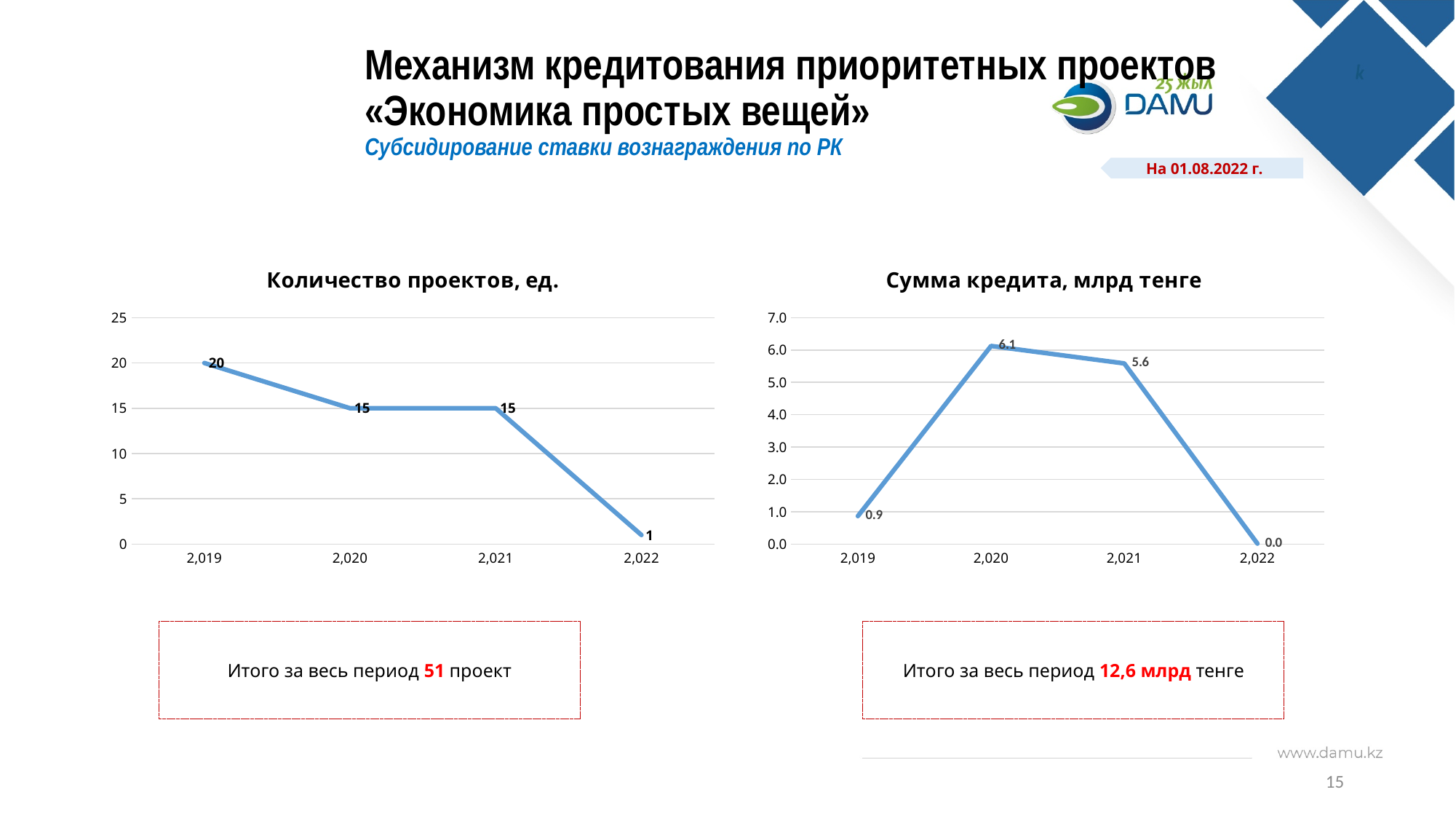
What kind of chart is the chart titled "Сумма кредита, млрд тенге"? line chart In the chart titled "Сумма кредита, млрд тенге", what is the value for 2,019? 0.9 In the chart titled "Количество проектов, ед.", which year has the highest value? 2,019 In the chart titled "Сумма кредита, млрд тенге", what is the difference between the values for 2,020 and 2,021? 0.5 In the chart titled "Количество проектов, ед.", how many data points are plotted? 4 In the chart titled "Сумма кредита, млрд тенге", which is larger, the value for 2,020 or the value for 2,021? 2,020 In the chart titled "Количество проектов, ед.", do the values rise or fall from 2,019 to 2,022? fall In the chart titled "Количество проектов, ед.", what is the difference between the values for 2,019 and 2,020? 5 In the chart titled "Количество проектов, ед.", what is the value for 2,022? 1 In the chart titled "Сумма кредита, млрд тенге", which year has the lowest value? 2,022 In the chart titled "Количество проектов, ед.", what is the value for 2,019? 20 In the chart titled "Сумма кредита, млрд тенге", what is the value for 2,020? 6.1